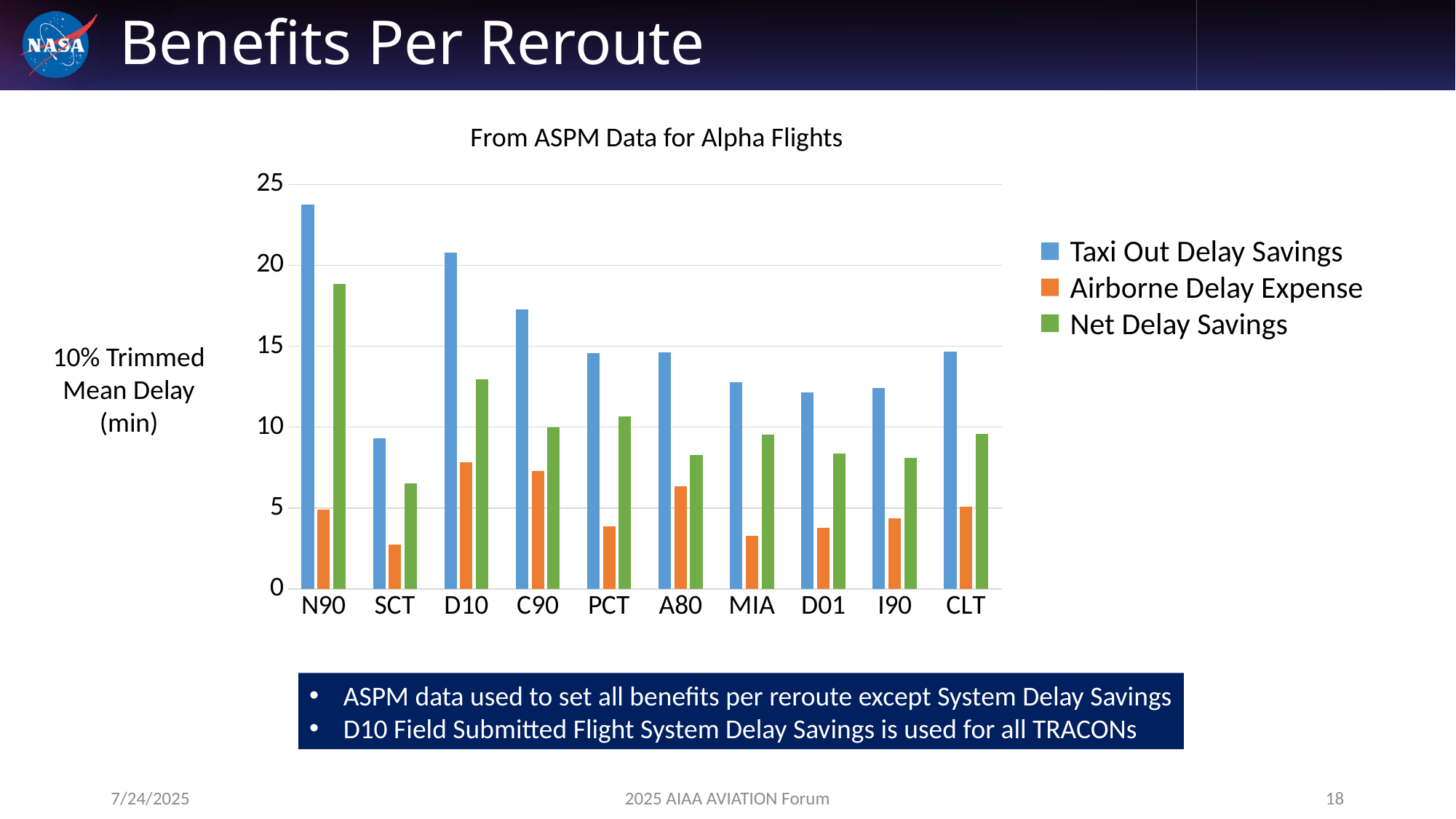
Is the Taxi Out Delay Savings value for N90 greater or less than 20? greater Is the Net Delay Savings value for N90 greater or less than 15? greater Which category has the lowest Taxi Out Delay Savings? SCT Which category has the highest Airborne Delay Expense? D10 Which category has the highest Taxi Out Delay Savings? N90 How many series does the legend list? 3 Is the Airborne Delay Expense value for MIA greater or less than 5? less How many TRACON categories are shown on the x axis? 10 Which category has the lowest Net Delay Savings? SCT What kind of chart is shown on the slide? Bar chart Which is larger, the Taxi Out Delay Savings for D10 or for C90? D10 What is the title of the chart? From ASPM Data for Alpha Flights